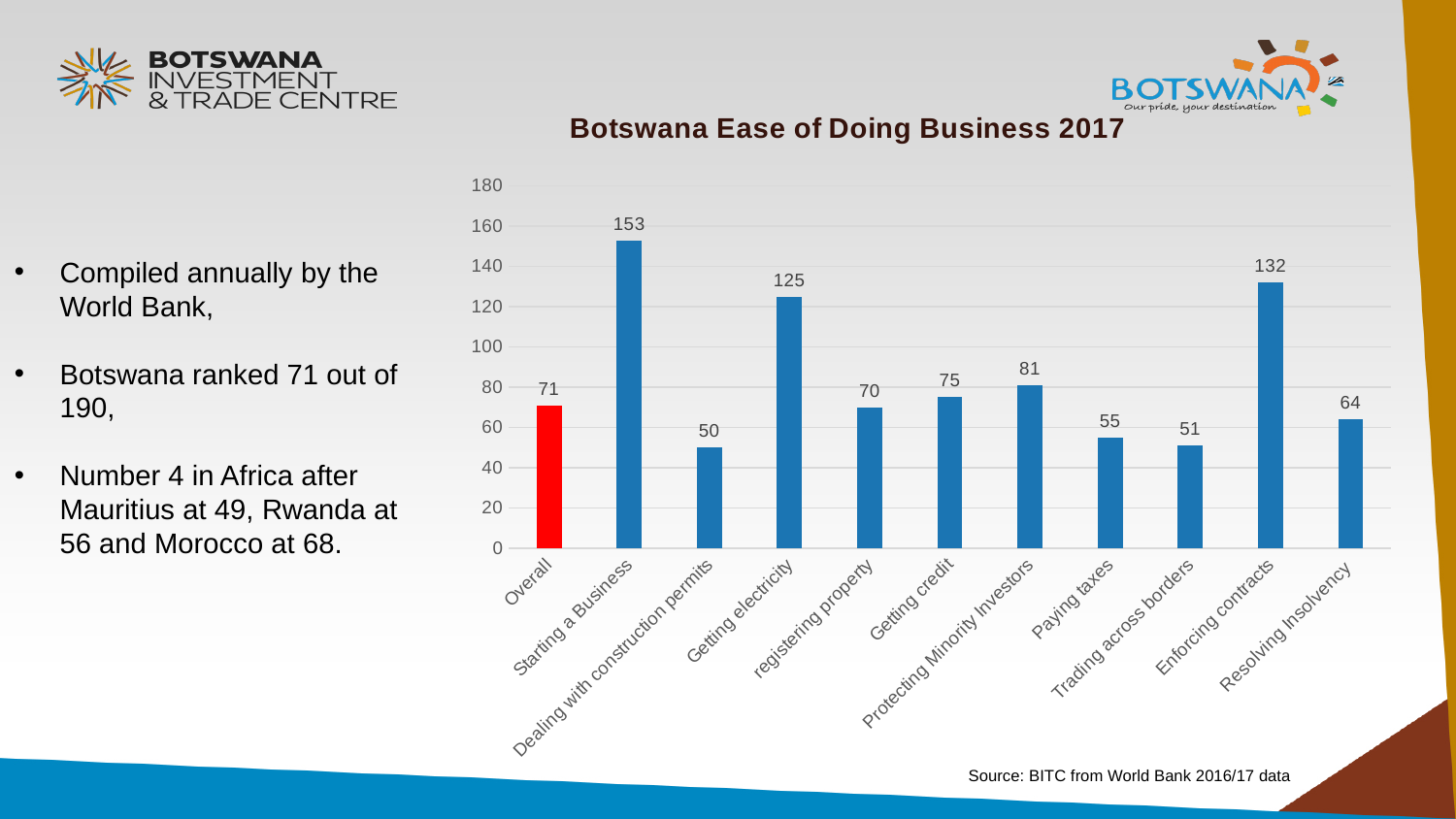
What is the value for Dealing with construction permits? 50 What is the title of the chart? Botswana Ease of Doing Business 2017 Which is larger, the value for Getting electricity or the value for Enforcing contracts? Enforcing contracts What is the difference between the values for Starting a Business and Overall? 82 How many categories are shown on the x axis? 11 Which category has the lowest value? Dealing with construction permits Is the value for Protecting Minority Investors greater or less than 100? less Which category has the highest value? Starting a Business Which bar is coloured red? Overall What is the value for Starting a Business? 153 What is the value for Enforcing contracts? 132 What kind of chart is shown? bar chart